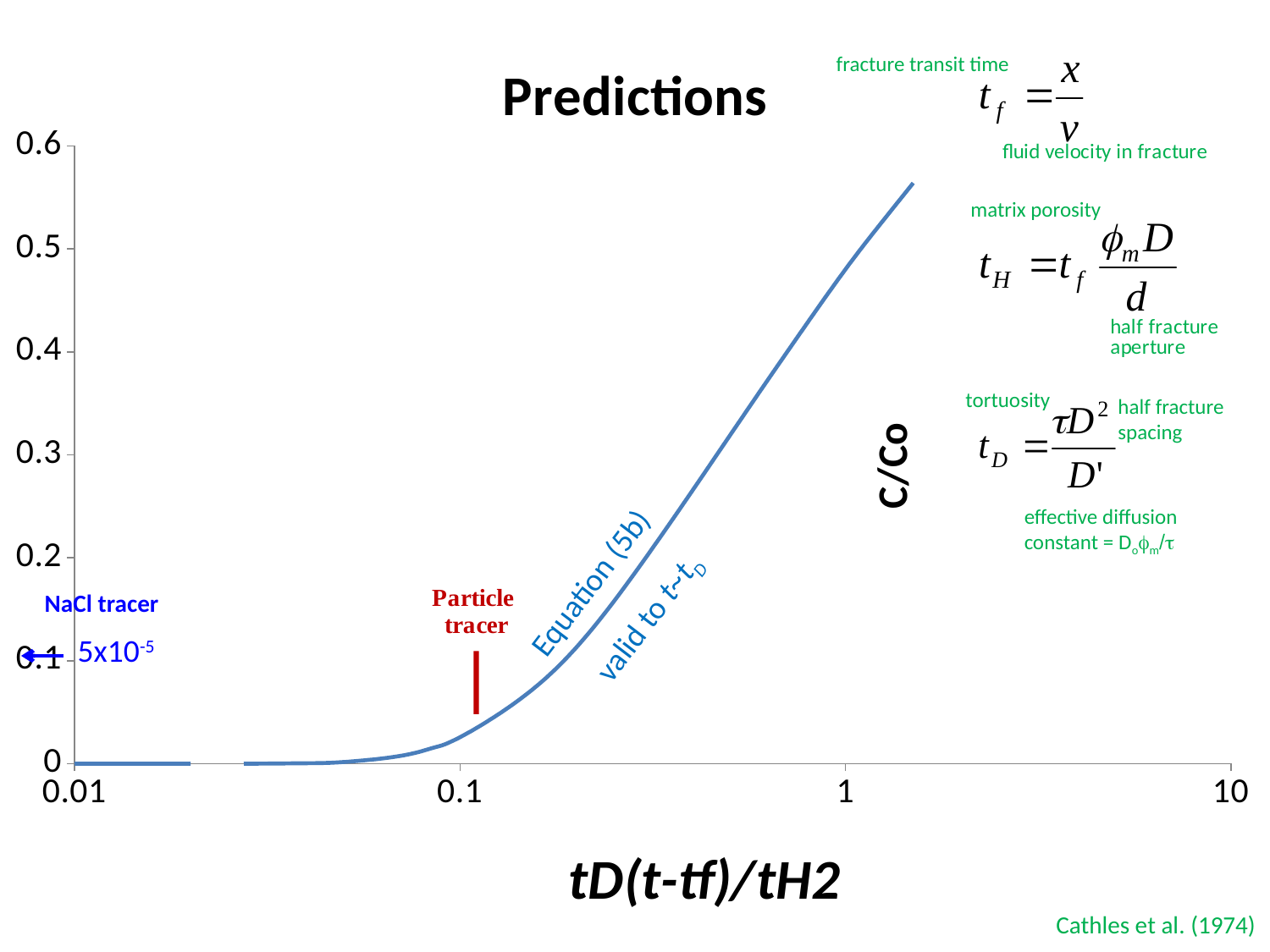
Is the value of the curve at x = 0.1 greater or less than 0.1? less What is the title of the chart? Predictions Which equation is the plotted curve labelled as? Equation (5b) Is the value of the curve at x = 0.3 greater or less than 0.3? less What is the highest tick value shown on the y axis? 0.6 Is the highest point of the curve greater or less than 0.5? greater What kind of chart is shown on the slide? line chart How many curves are plotted on the chart? 1 Does the plotted curve rise or fall as the x axis value increases from 0.1 to 1? rise